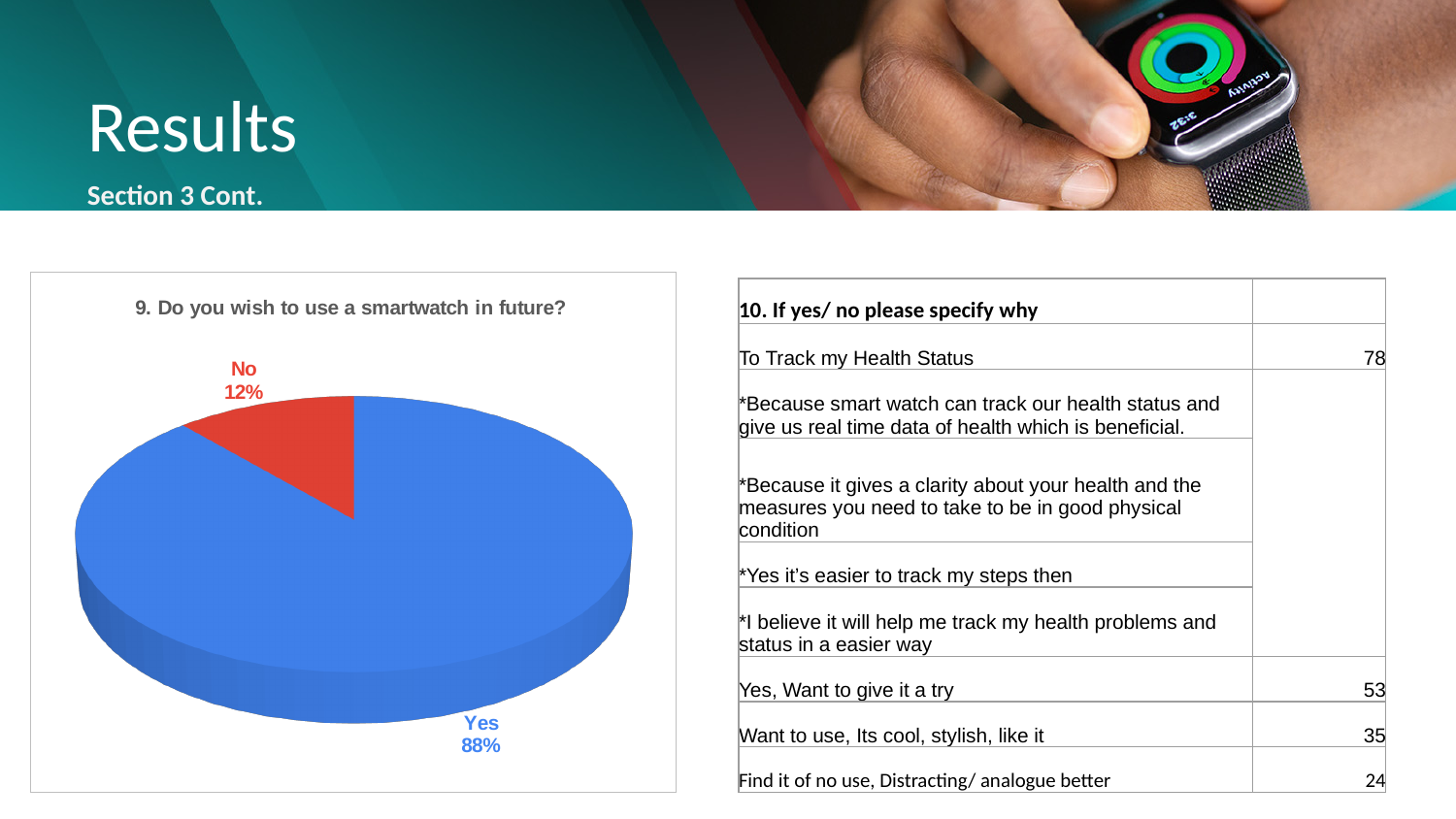
Which is larger, the Yes slice or the No slice? Yes How many slices does the pie chart have? 2 What is the title of the pie chart? 9. Do you wish to use a smartwatch in future? What is the difference in percentage points between the Yes and No slices? 76 What kind of chart is shown on the slide? pie chart What share of the pie is labelled No? 12% Which slice of the pie chart is the smallest? No What share of the pie is labelled Yes? 88% What colour is the Yes slice of the pie chart? blue Which slice of the pie chart is the largest? Yes